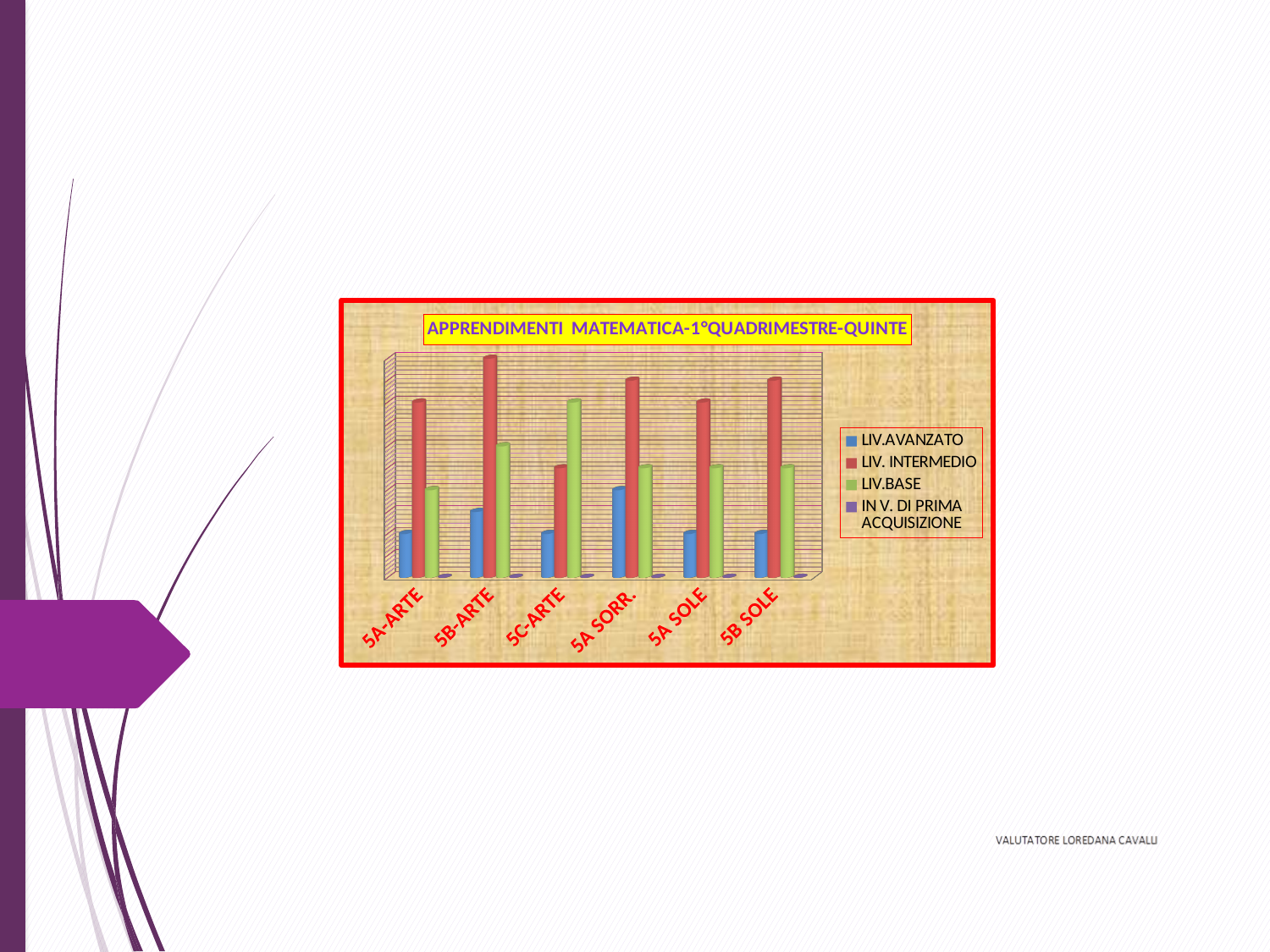
For 5A-ARTE, which is larger: LIV. INTERMEDIO or LIV.BASE? LIV. INTERMEDIO Which class has the highest LIV. INTERMEDIO bar? 5B-ARTE What kind of chart is shown on the slide? bar chart Which class has the lowest LIV.BASE bar? 5A-ARTE Which class has the highest LIV.AVANZATO bar? 5A SORR. Which class has the highest LIV.BASE bar? 5C-ARTE What is the title of the chart? APPRENDIMENTI MATEMATICA-1°QUADRIMESTRE-QUINTE For 5C-ARTE, which is larger: LIV.BASE or LIV. INTERMEDIO? LIV.BASE How many categories (classes) are shown on the x axis of the chart? 6 Which colour represents LIV. INTERMEDIO in the chart? red How many series does the chart's legend list? 4 Which class has the lowest LIV. INTERMEDIO bar? 5C-ARTE